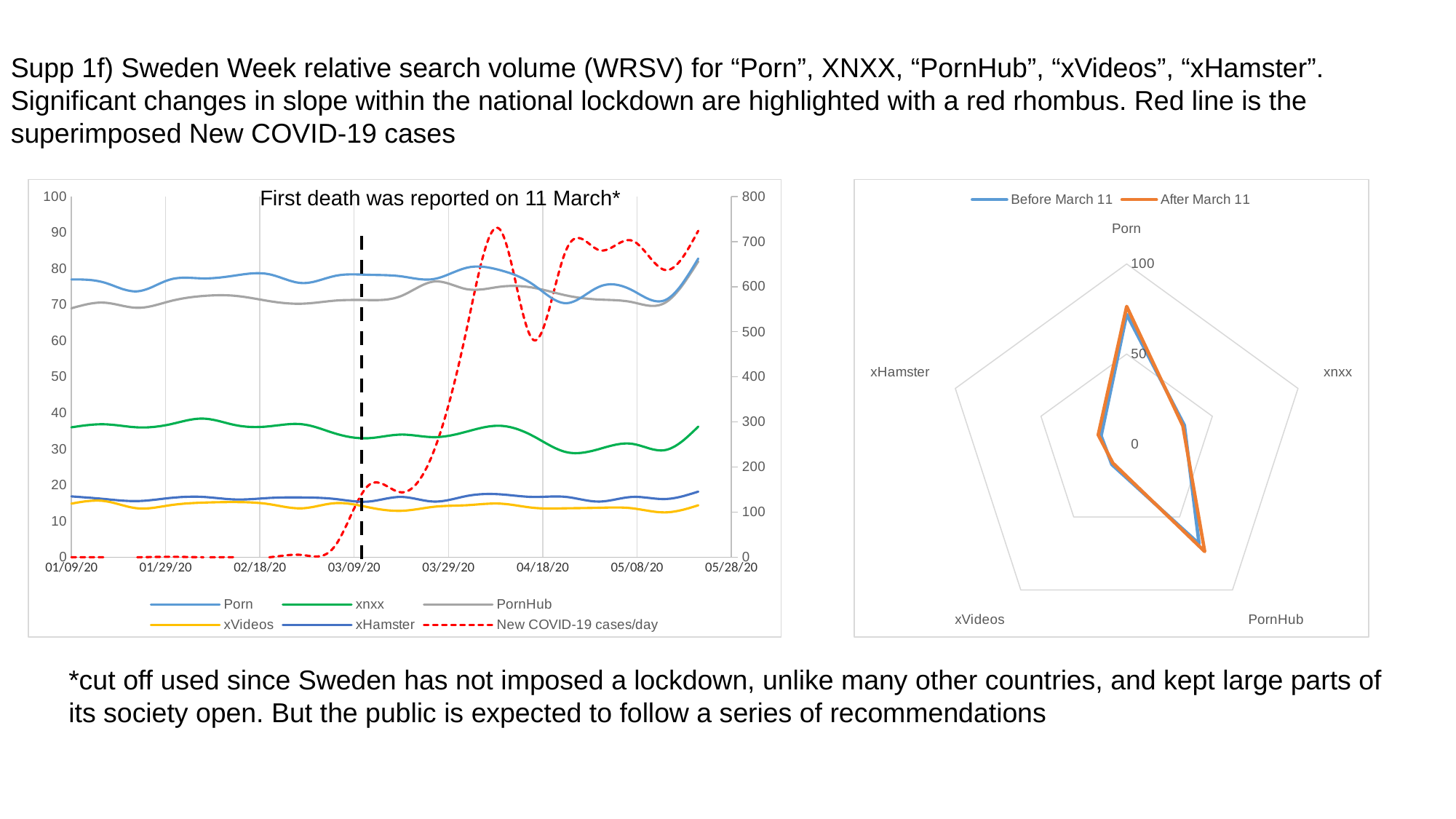
What kind of chart is the left chart? line chart In the left chart, is the WRSV for xnxx on 01/09/20 greater or less than 30? greater In the left chart, what event does the dashed vertical line mark? First death was reported on 11 March How many series does the legend of the left chart list? 6 How many series does the legend of the right chart list? 2 How many categories does the right chart have? 5 In the right chart, is the value for Porn greater or less than 50? greater In the left chart, does the New COVID-19 cases/day line rise or fall between 03/09/20 and 03/29/20? rise In the left chart, which search term has the highest WRSV across the period? Porn What kind of chart is the right chart? radar chart In the left chart, is the WRSV for Porn on 01/09/20 greater or less than 70? greater In the left chart, which is larger on 02/18/20, the WRSV for xnxx or for PornHub? PornHub